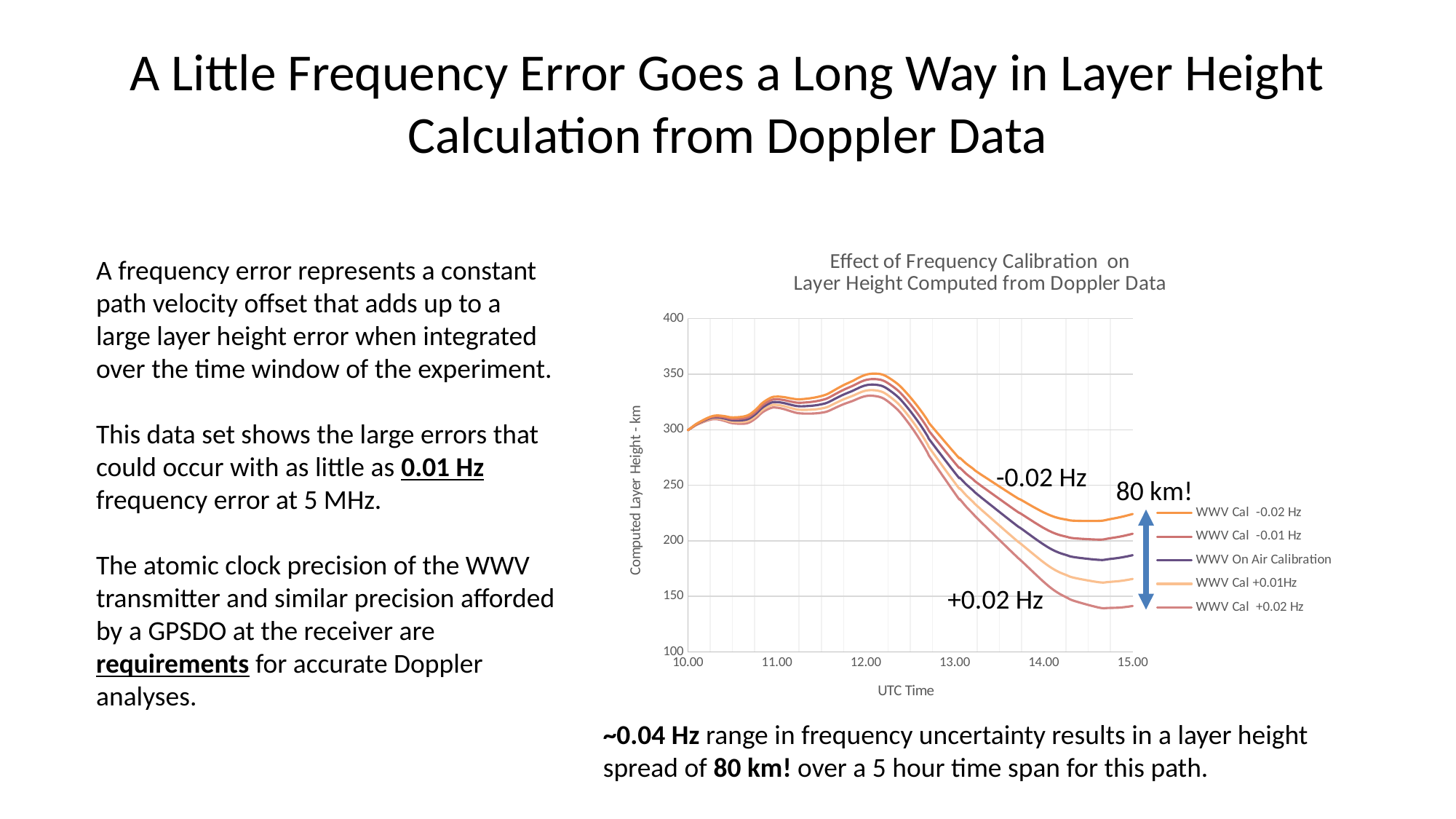
What kind of chart is shown on the slide? line chart At 15.00 UTC, is the value for WWV Cal +0.02 Hz greater or less than 150? less Is the peak value of the WWV Cal +0.02 Hz series greater or less than 350? less At 15.00 UTC, which is larger: the value for WWV Cal -0.01 Hz or the value for WWV Cal +0.01Hz? WWV Cal -0.01 Hz Which series has the lowest computed layer height at 15.00 UTC? WWV Cal +0.02 Hz How many series does the chart legend list? 5 What is the title of the chart? Effect of Frequency Calibration on Layer Height Computed from Doppler Data At 15.00 UTC, is the value for WWV On Air Calibration greater or less than 200? less Which series has the highest computed layer height at 15.00 UTC? WWV Cal -0.02 Hz What is the label of the chart's vertical axis? Computed Layer Height - km Do the computed layer height values rise or fall between 12.00 and 15.00 UTC? fall